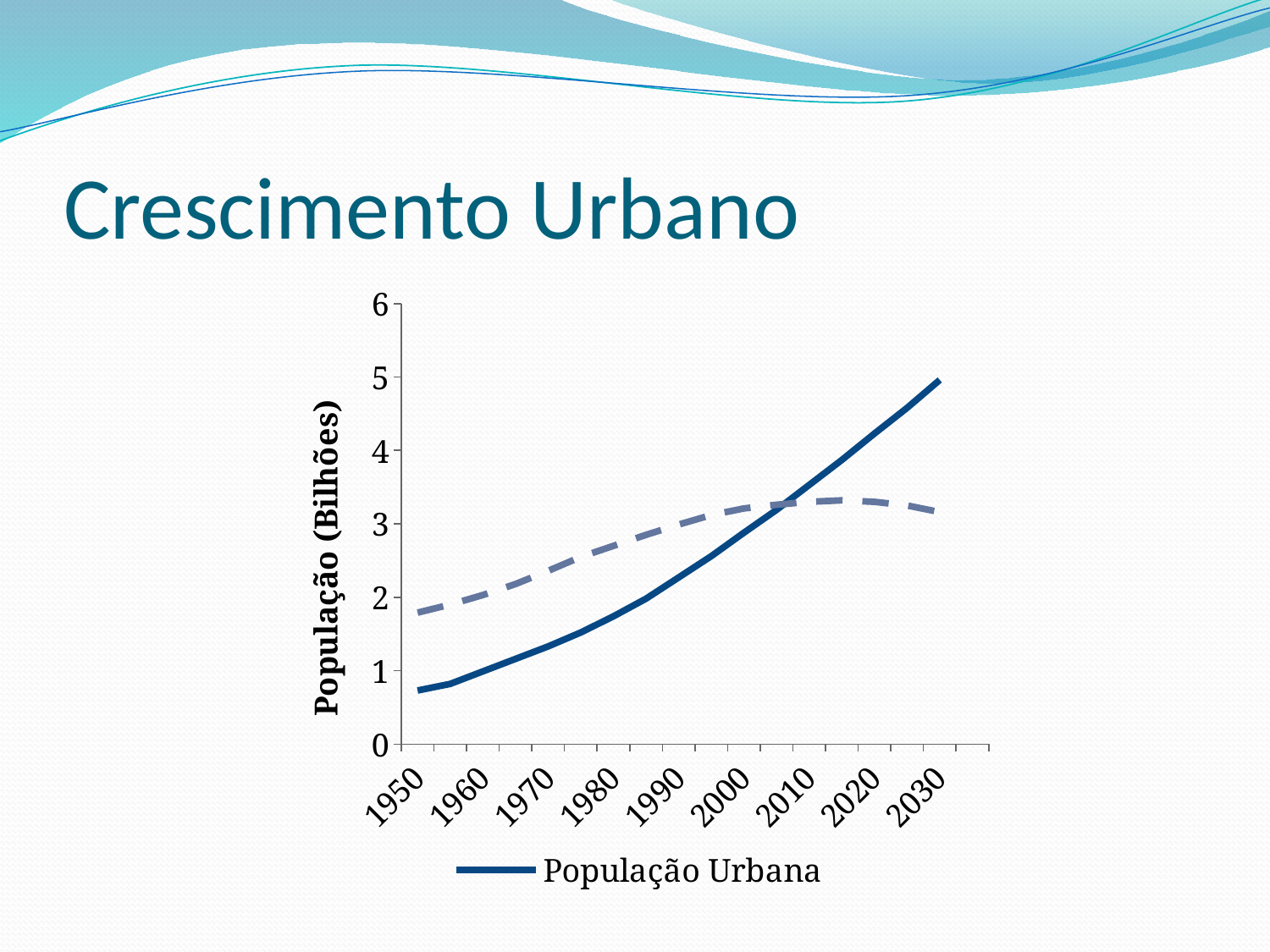
What is the label of the vertical axis? População (Bilhões) In 2030, which line is higher: the solid População Urbana line or the dashed line? the solid População Urbana line Does the População Urbana line rise or fall from 1950 to 2030? rises Is the value of População Urbana in 2030 greater or less than 4? greater What kind of chart is shown on the slide? line chart Is the value of the dashed line in 1950 greater or less than 2? less How many series does the chart legend list? 1 Is the value of População Urbana in 2000 greater or less than 2? greater What is the name of the series listed in the legend? População Urbana In 1950, which line is higher: the solid População Urbana line or the dashed line? the dashed line How many year labels are shown along the x axis? 9